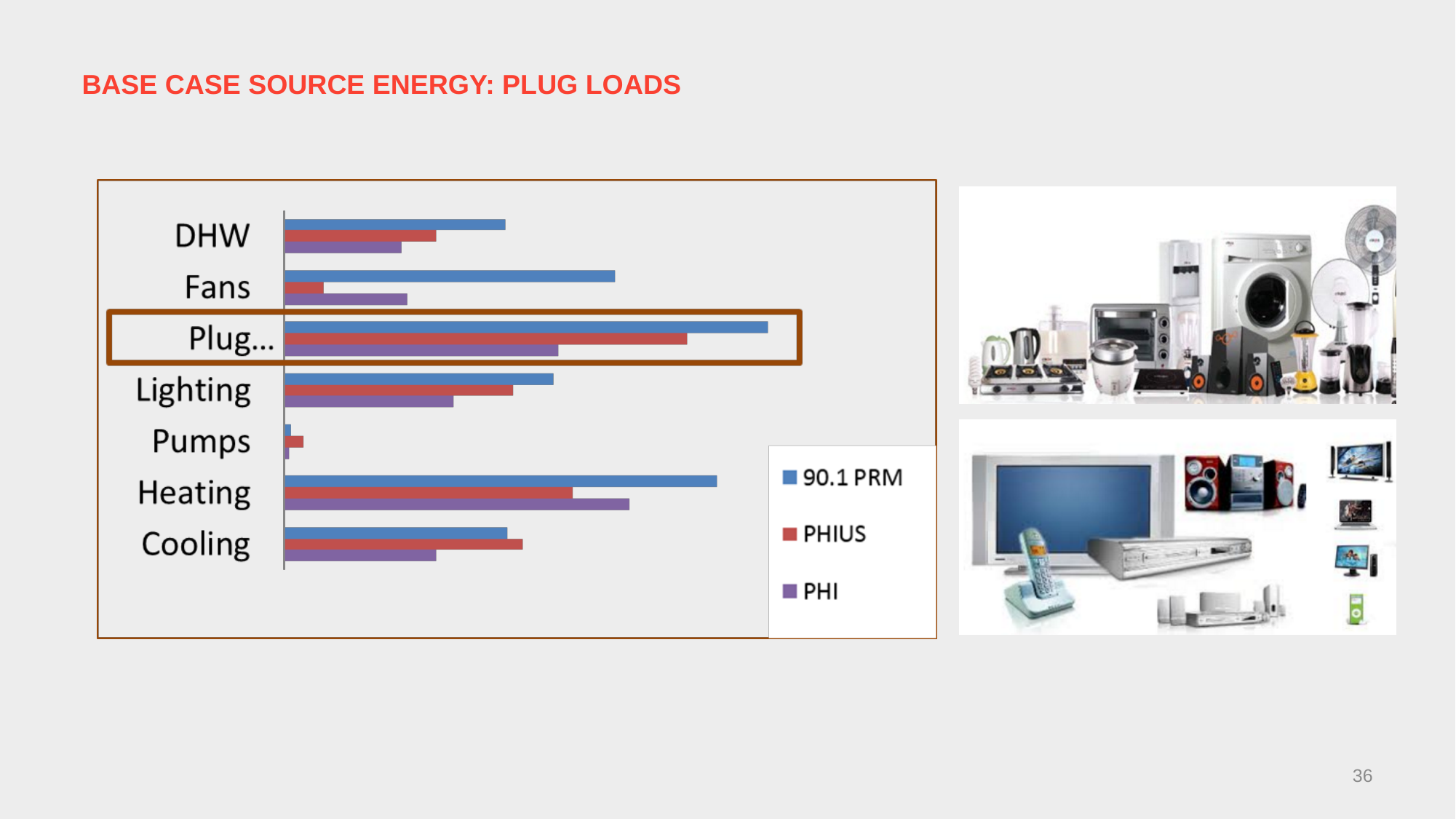
For Cooling, which is larger: the PHIUS value or the PHI value? PHIUS Which category has the highest PHIUS value? Plug Which category has the highest PHI value? Heating How many categories are plotted on the chart? 7 For Heating, which is larger: the PHIUS value or the PHI value? PHI For Fans, which is larger: the 90.1 PRM value or the PHIUS value? 90.1 PRM Which category has the lowest 90.1 PRM value? Pumps How many series does the chart's legend list? 3 What kind of chart is shown on the slide? Bar chart Which category on the chart is outlined with a brown box? Plug Which category has the highest 90.1 PRM value? Plug Which category has the lowest PHI value? Pumps